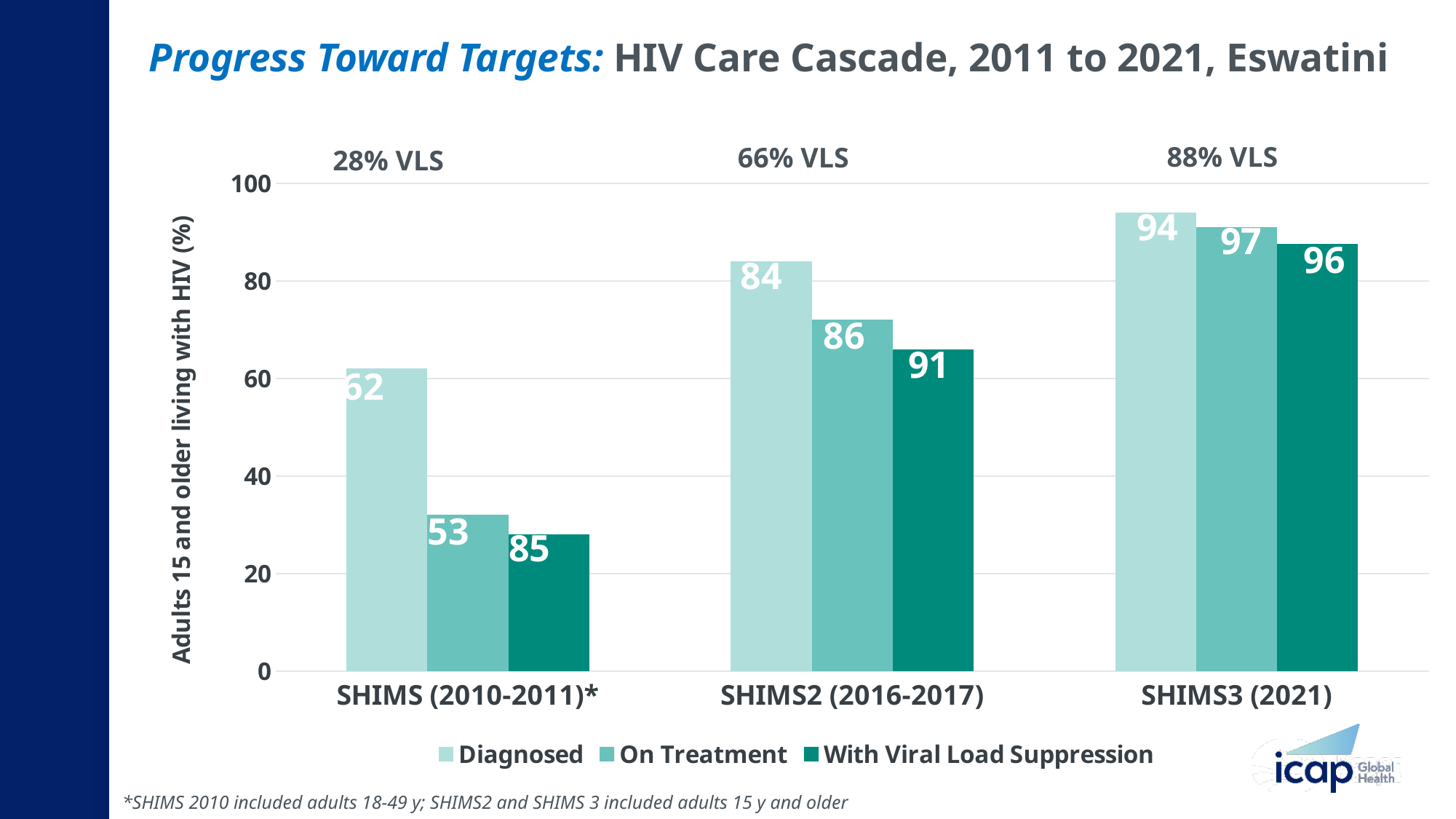
Do the Diagnosed data labels rise or fall from SHIMS (2010-2011)* to SHIMS3 (2021)? Rise What is the data label for Diagnosed in the SHIMS (2010-2011)* group? 62 Which has the larger Diagnosed data label, SHIMS2 (2016-2017) or SHIMS3 (2021)? SHIMS3 (2021) How many series does the legend list? 3 In which survey group is the Diagnosed data label highest? SHIMS3 (2021) What is the data label for On Treatment in the SHIMS2 (2016-2017) group? 86 In which survey group is the On Treatment data label lowest? SHIMS (2010-2011)* What kind of chart is shown on the slide? Bar chart What is the data label for On Treatment in the SHIMS (2010-2011)* group? 53 What is the difference between the Diagnosed data labels for SHIMS3 (2021) and SHIMS (2010-2011)*? 32 What is the data label for With Viral Load Suppression in the SHIMS3 (2021) group? 96 How many survey groups are shown on the x axis? 3